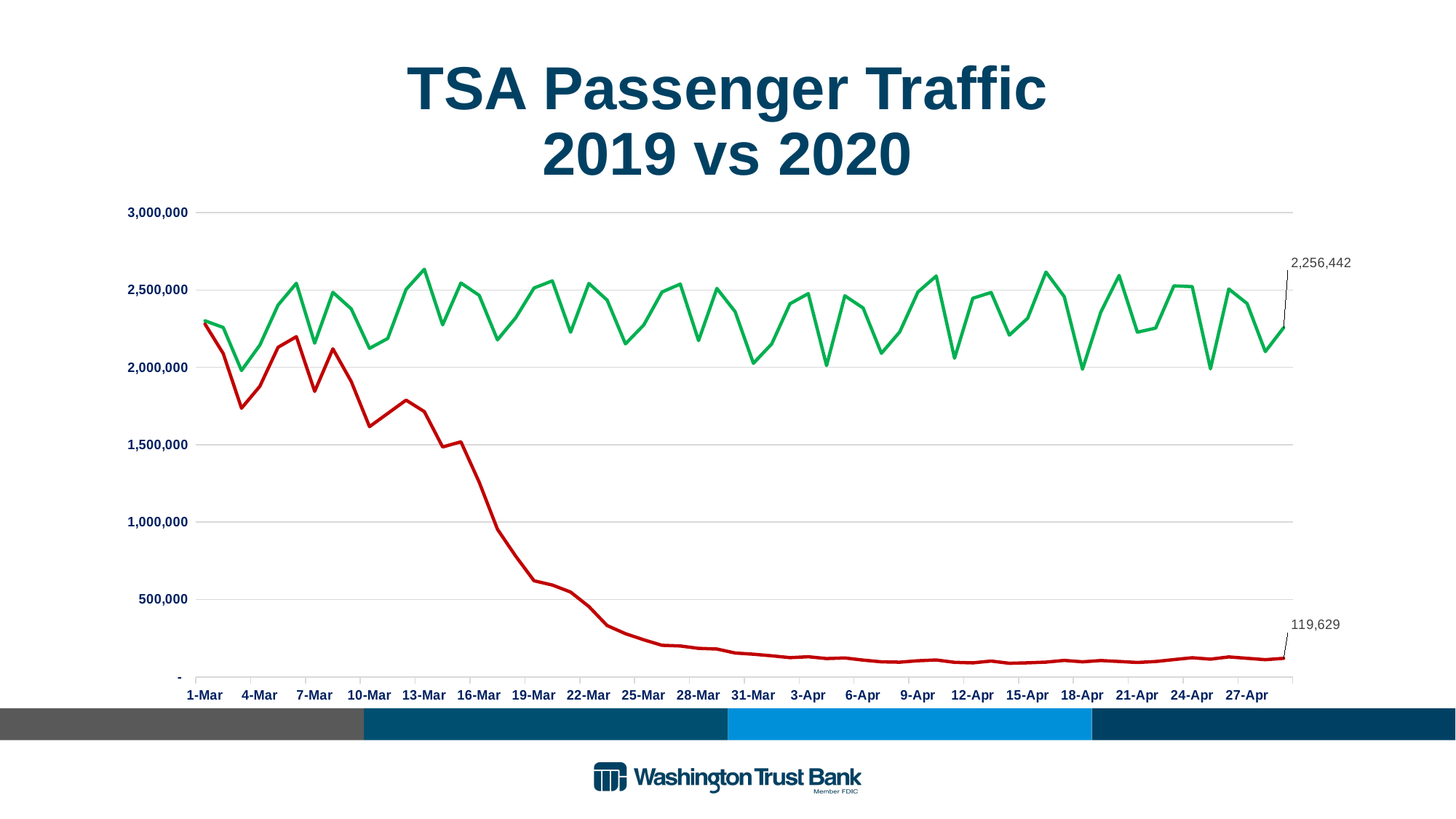
Is the value of the red line on 19-Mar greater or less than 1,000,000? less Is the value of the red line on 1-Mar greater or less than 2,000,000? greater What is the highest value shown on the vertical axis? 3,000,000 What is the labelled value at the end of the red line? 119,629 What is the difference between the two labelled end values, 2,256,442 and 119,629? 2,136,813 Does the red line rise or fall overall from 1-Mar to the end of April? fall What kind of chart is shown on the slide? line chart What is the labelled value at the end of the green line? 2,256,442 How many lines are plotted on the chart? 2 At the final point on the chart, which line has the larger value, the green line or the red line? the green line What is the title of the chart? TSA Passenger Traffic 2019 vs 2020 Is the value of the red line on 25-Mar greater or less than 500,000? less